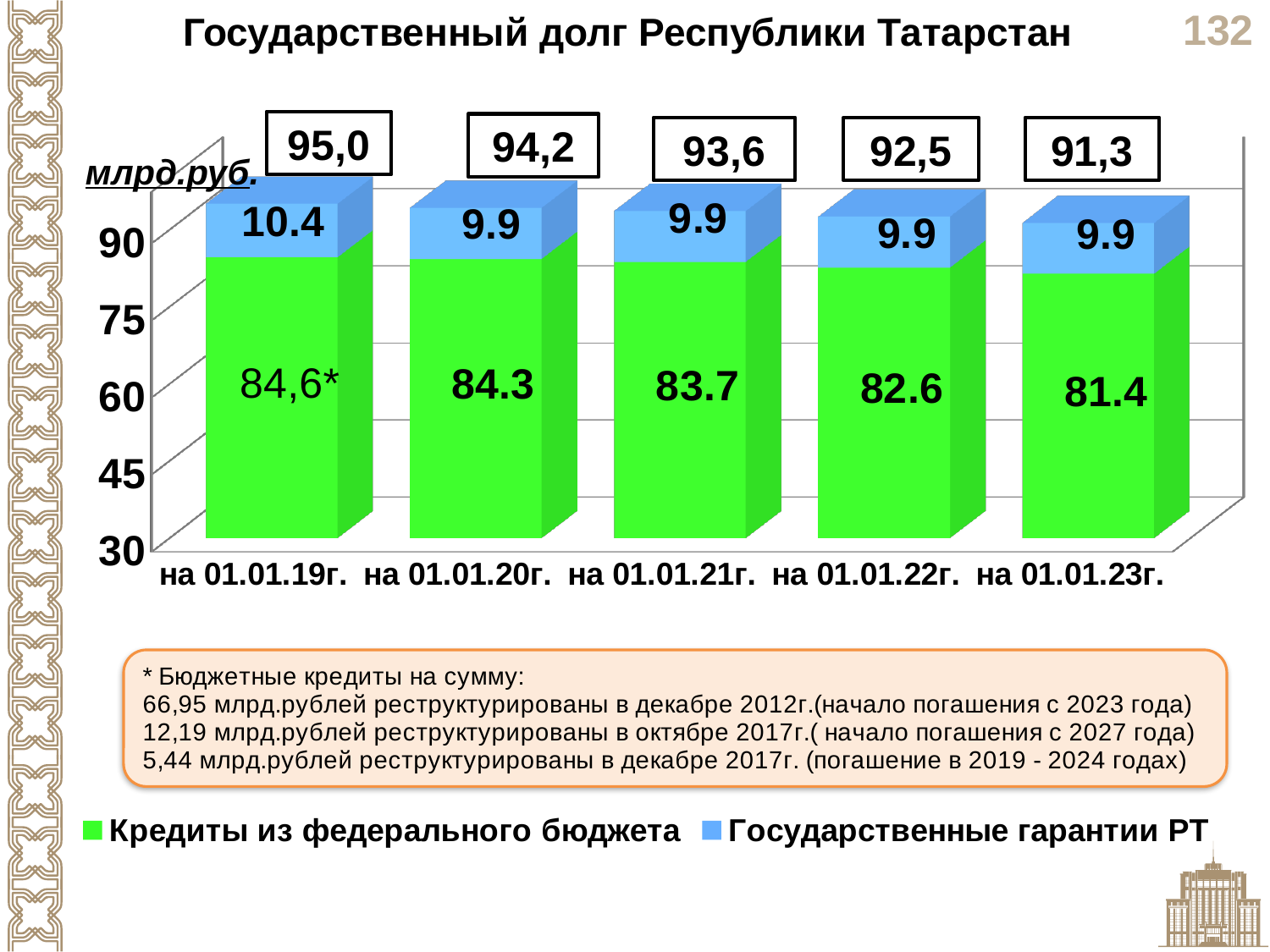
What is the difference between Кредиты из федерального бюджета на 01.01.20г. and на 01.01.22г.? 1.7 Do the total state debt values rise or fall from 01.01.19г. to 01.01.23г.? fall What is the value of Кредиты из федерального бюджета на 01.01.20г.? 84.3 What is the total state debt shown above the bar for 01.01.21г.? 93,6 What is the value of Государственные гарантии РТ на 01.01.19г.? 10.4 On which date is the total state debt the highest? на 01.01.19г. What is the value of Кредиты из федерального бюджета на 01.01.23г.? 81.4 How many categories (dates) are shown on the x axis? 5 Which colour represents Государственные гарантии РТ in the chart? blue What type of chart is shown on the slide? bar chart How many series does the legend list? 2 On which date is the value of Кредиты из федерального бюджета the lowest? на 01.01.23г.